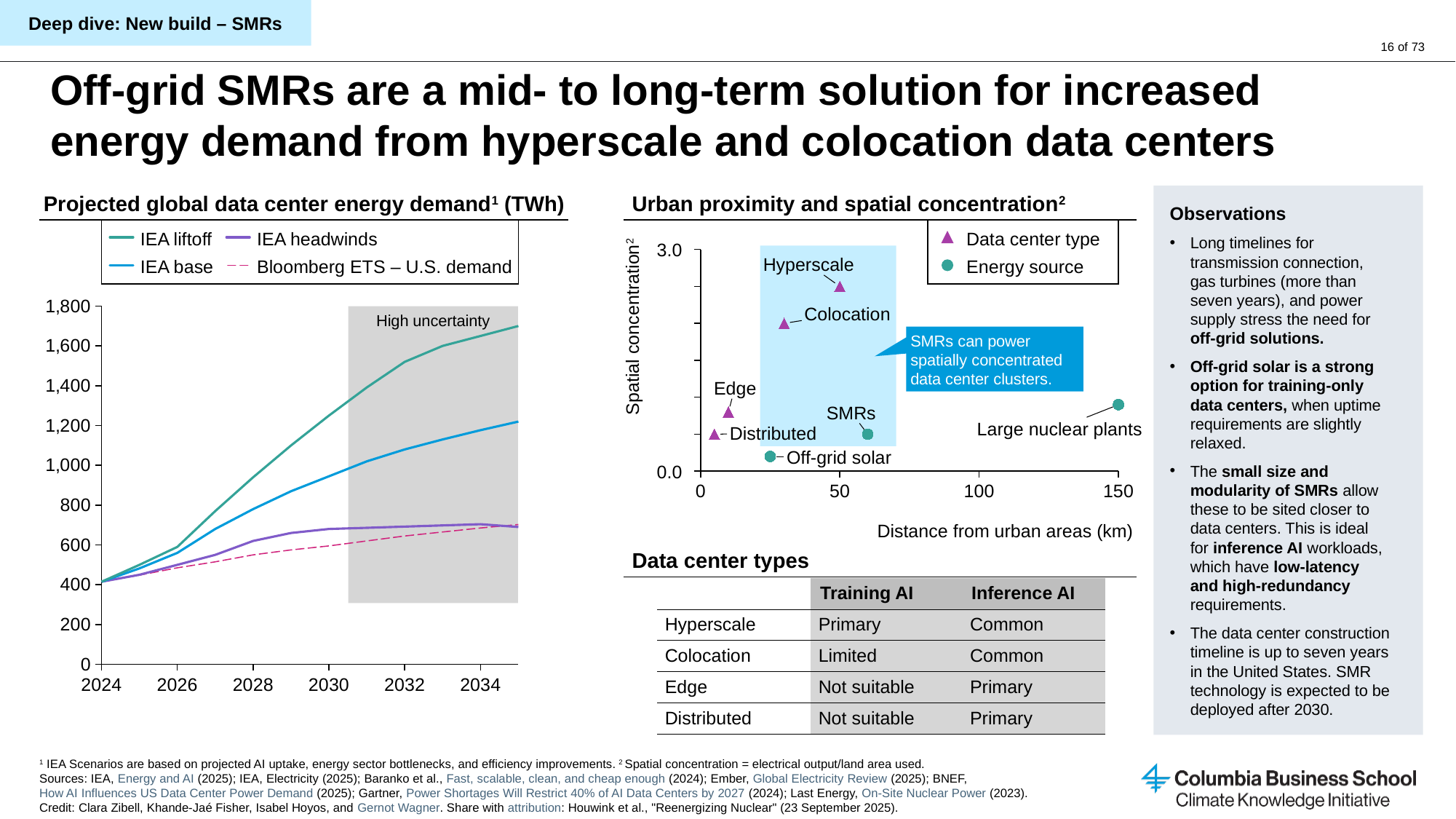
In the 'Projected global data center energy demand (TWh)' chart, is the IEA headwinds value for 2034 greater or less than 800? less In the 'Projected global data center energy demand (TWh)' chart, which series has the highest value in 2034? IEA liftoff What type of chart is the 'Projected global data center energy demand (TWh)' chart? line chart How many series does the legend of the 'Urban proximity and spatial concentration' chart list? 2 In the 'Urban proximity and spatial concentration' chart, is the distance from urban areas for Large nuclear plants greater or less than 100 km? greater What label is shown on the shaded region of the 'Projected global data center energy demand (TWh)' chart? High uncertainty In the 'Projected global data center energy demand (TWh)' chart, which is larger in 2030: IEA base or IEA headwinds? IEA base In the 'Projected global data center energy demand (TWh)' chart, is the IEA liftoff value for 2034 greater or less than 1,600? greater How many series does the legend of the 'Projected global data center energy demand (TWh)' chart list? 4 In the 'Projected global data center energy demand (TWh)' chart, does the IEA liftoff series rise or fall from 2024 to 2034? rise In the 'Urban proximity and spatial concentration' chart, which point has the highest spatial concentration? Hyperscale In the 'Urban proximity and spatial concentration' chart, how many data center type points are plotted? 4